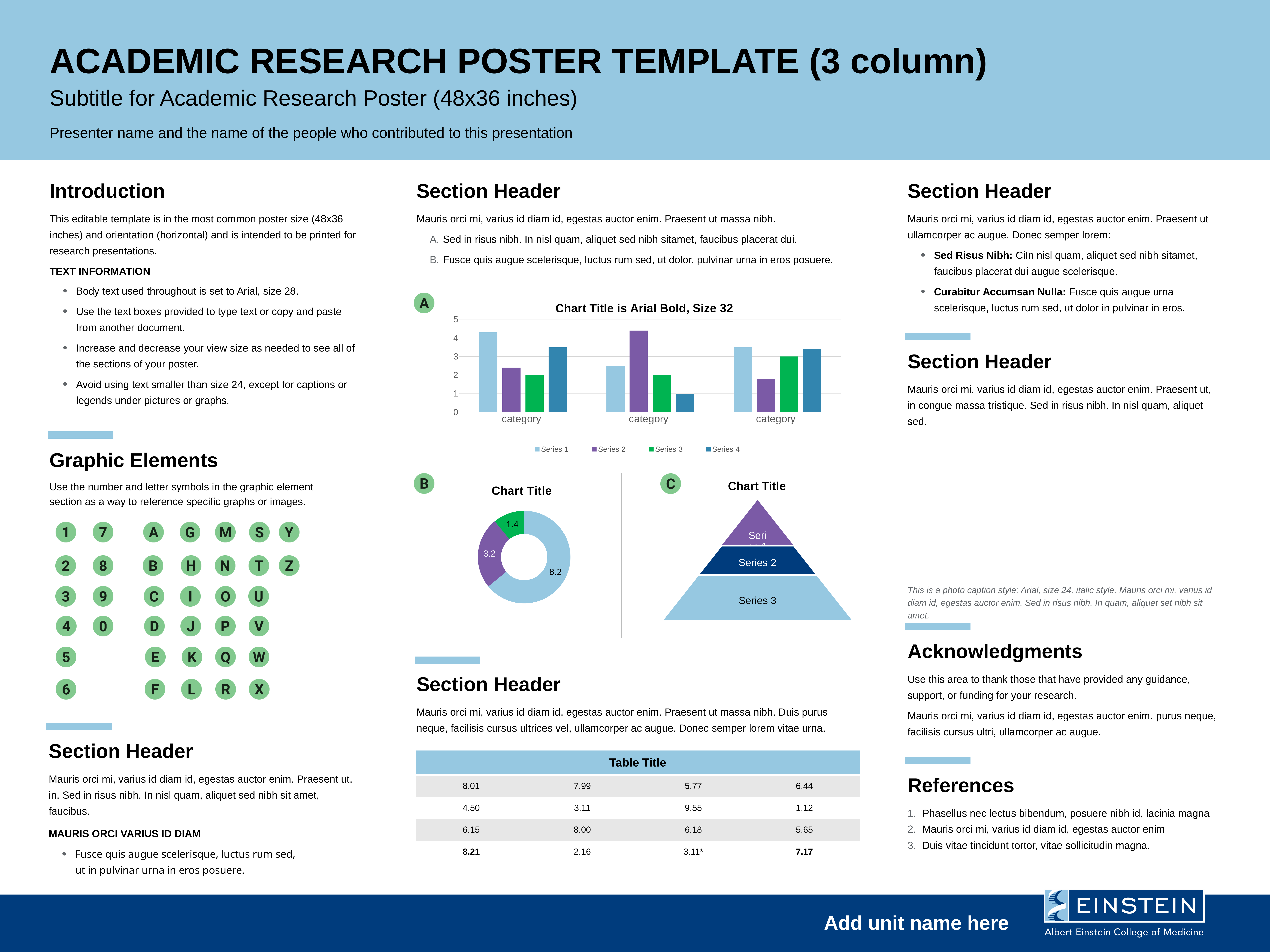
How many category groups are plotted in chart A? 3 How many series does the legend of chart A list? 4 In chart A, is the Series 4 bar in the middle category group greater or less than 2? less What kind of chart is chart B? doughnut chart In chart B, what is the value of the largest slice? 8.2 What kind of chart is chart A (titled "Chart Title is Arial Bold, Size 32")? bar chart In chart A, is the Series 2 bar in the middle category group greater or less than 4? greater In chart A, is the Series 1 bar in the first (leftmost) category group greater or less than 4? greater In chart B, what is the difference between the largest slice (8.2) and the purple slice (3.2)? 5.0 In chart A, which series has the tallest bar in the middle category group? Series 2 In chart A, in the first (leftmost) category group, which is larger: the Series 1 bar or the Series 3 bar? Series 1 In chart A, which series has the shortest bar in the middle category group? Series 4